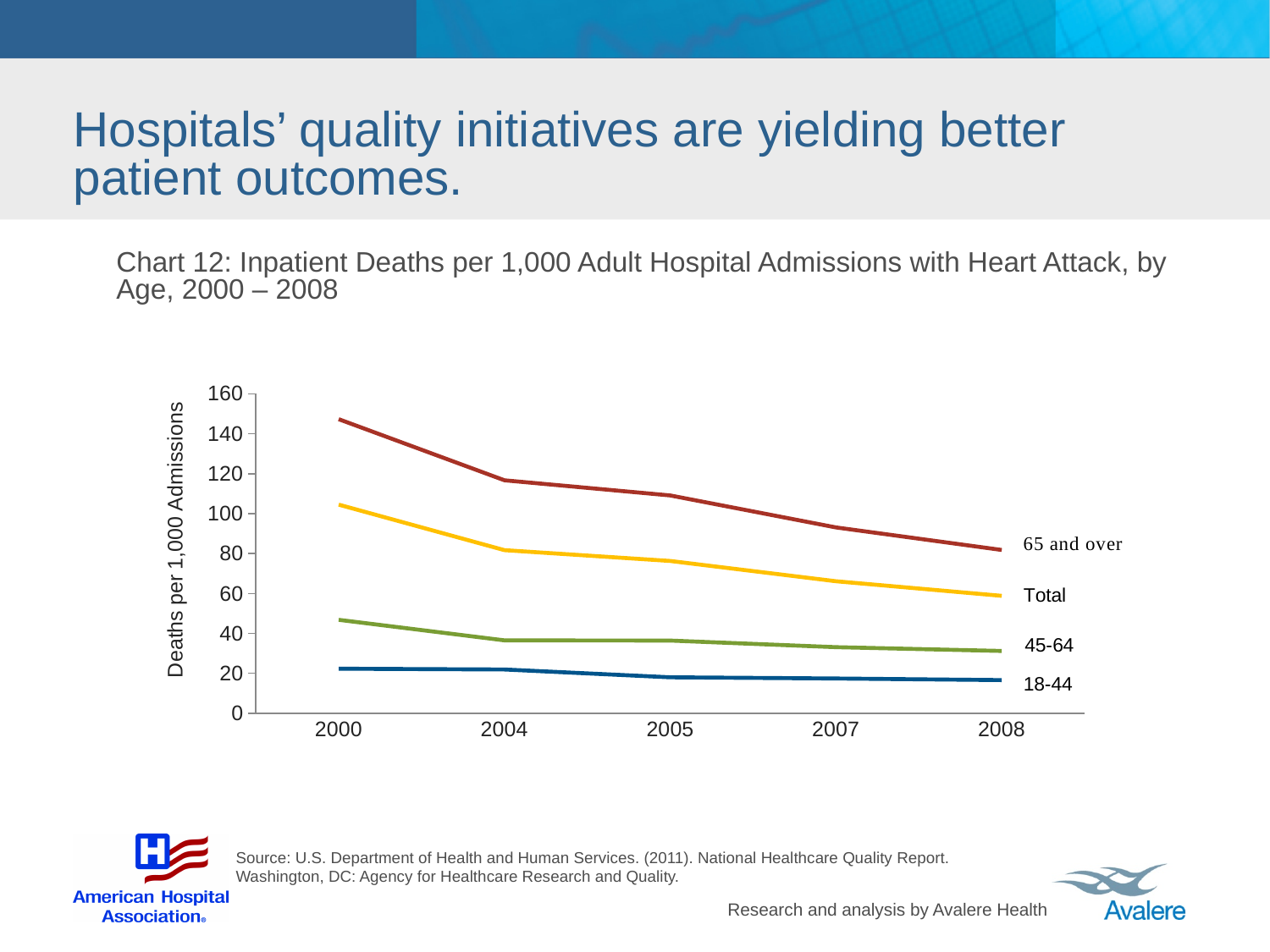
Is the value for Total in 2004 greater or less than 100? less Is the value for 18-44 in 2008 greater or less than 20? less What kind of chart is shown on the slide? line chart Does the death rate for the 65 and over group rise or fall from 2000 to 2008? fall What is the label on the y axis of the chart? Deaths per 1,000 Admissions How many series (lines) are plotted on the chart? 4 Which age group has the highest inpatient death rate in 2000? 65 and over Is the value for 65 and over in 2008 greater or less than 100? less Which age group has the lowest inpatient death rate in 2008? 18-44 How many years are shown along the x axis of the chart? 5 In 2008, which is larger: the value for 65 and over or the value for Total? 65 and over